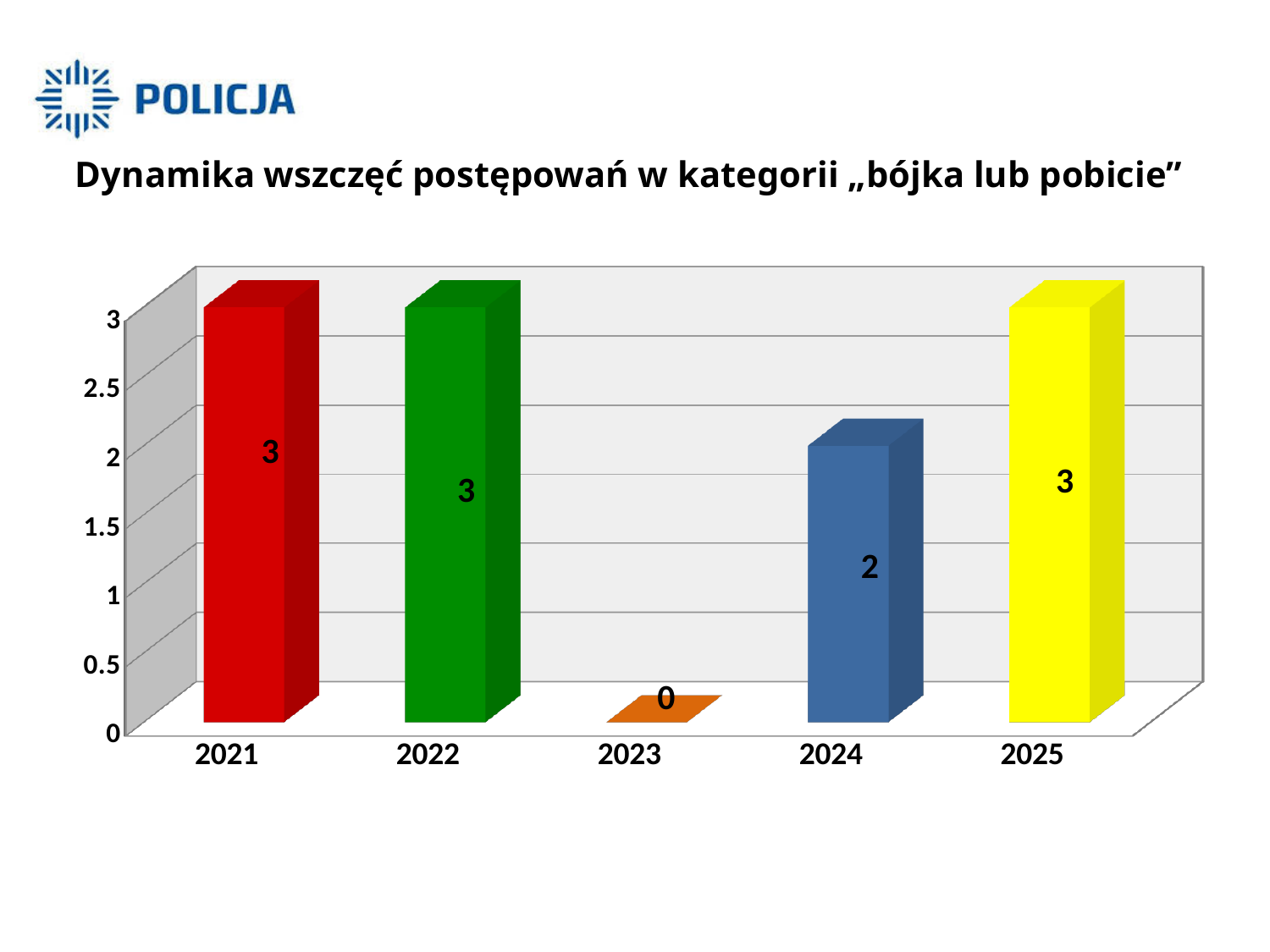
What is the value for 2025? 3 Which year has the lowest value? 2023 Is the value for 2024 greater or less than 1? greater What colour is the bar for 2022? green What is the value for 2024? 2 Which is larger, the value for 2024 or the value for 2025? 2025 What is the value for 2021? 3 What is the difference between the values for 2022 and 2024? 1 What kind of chart is shown on the slide? bar chart What is the value for 2023? 0 How many years are shown on the x axis? 5 What is the title of the chart? Dynamika wszczęć postępowań w kategorii „bójka lub pobicie”